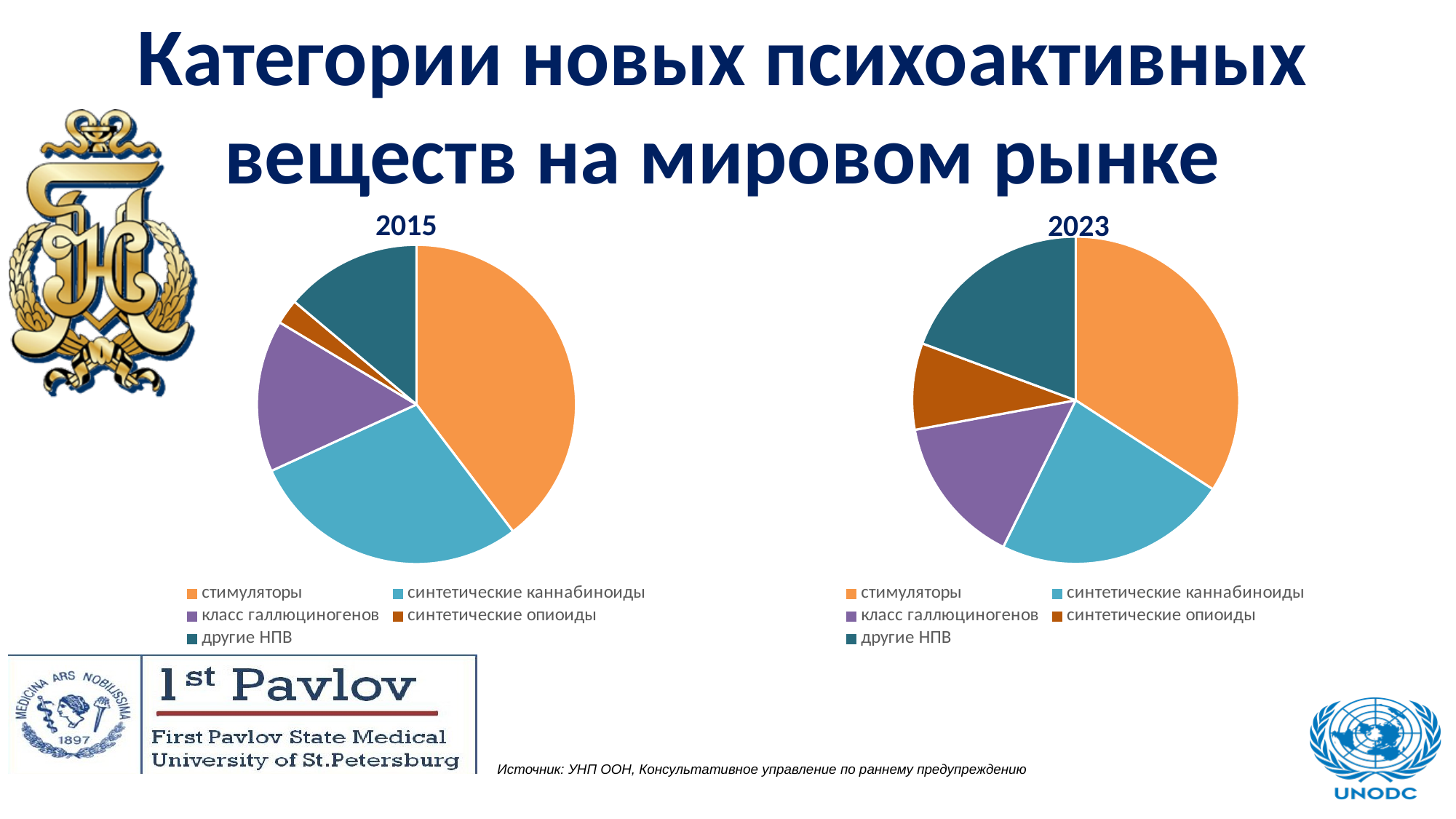
What colour represents стимуляторы in the pie charts? orange In the 2023 pie chart, which category has the smallest slice? синтетические опиоиды In the 2023 pie chart, which category has the largest slice? стимуляторы In the 2023 pie chart, which slice is larger: другие НПВ or синтетические опиоиды? другие НПВ What kind of chart is the 2015 chart? pie chart In the 2015 pie chart, which category has the largest slice? стимуляторы Which year does the pie chart on the left of the slide show? 2015 In the 2015 pie chart, which slice is larger: синтетические каннабиноиды or класс галлюциногенов? синтетические каннабиноиды How many entries does the legend of the 2023 pie chart list? 5 What kind of chart is the 2023 chart? pie chart In the 2015 pie chart, which category has the smallest slice? синтетические опиоиды How many slices does the 2015 pie chart have? 5